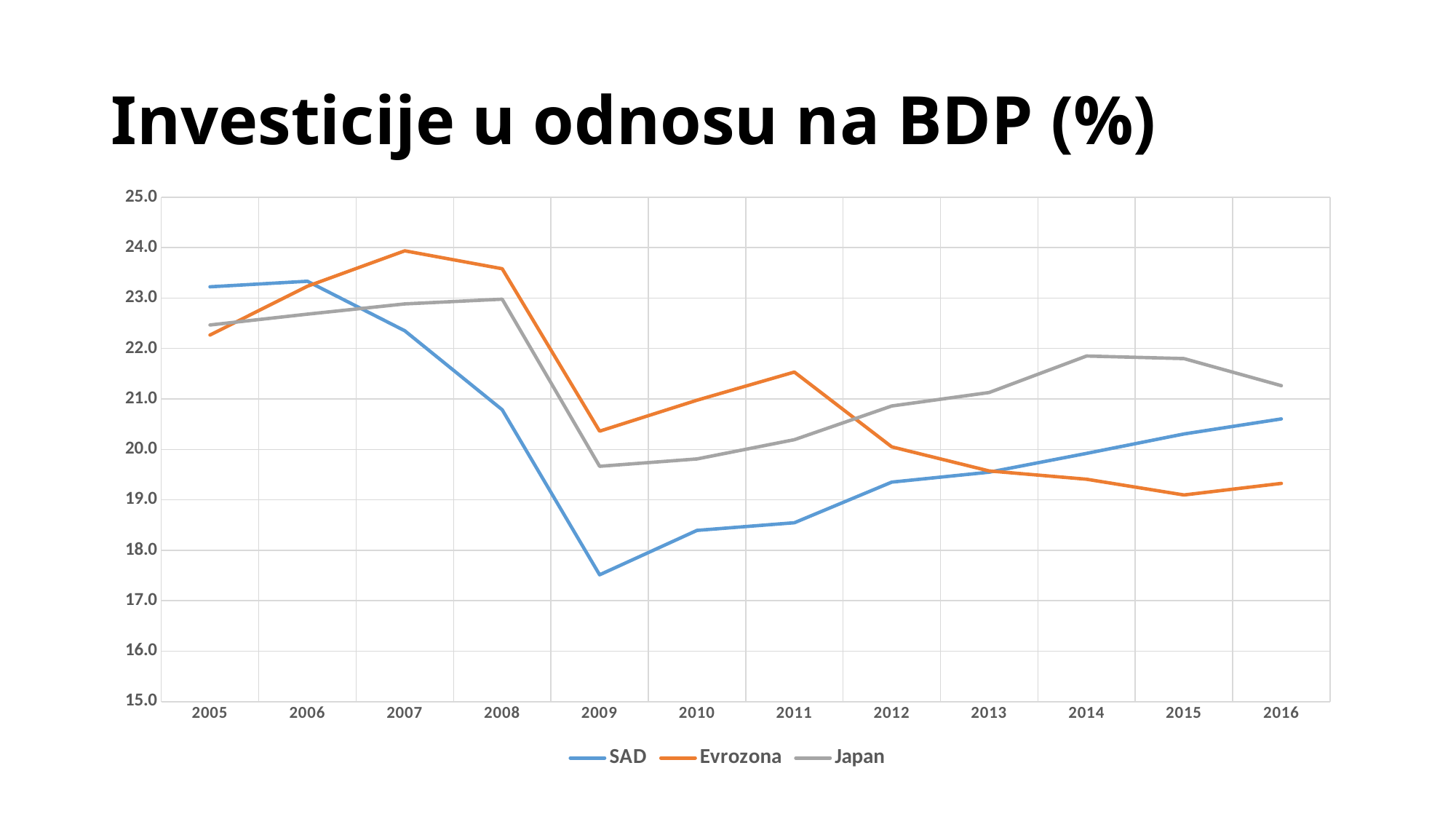
In which year does the SAD series reach its lowest value? 2009 Does the SAD series rise or fall from 2009 to 2016? rise What kind of chart is shown on the slide? line chart How many years are plotted along the x axis? 12 Is the value for SAD in 2009 greater or less than 18.0? less In 2009, which is larger: the value for SAD or the value for Evrozona? Evrozona What is the title of the chart? Investicije u odnosu na BDP (%) How many series does the legend list? 3 Which series has the highest value in 2016? Japan Is the value for Japan in 2014 greater or less than 21.0? greater Is the value for Evrozona in 2007 greater or less than 23.0? greater In which year does the Evrozona series reach its highest value? 2007